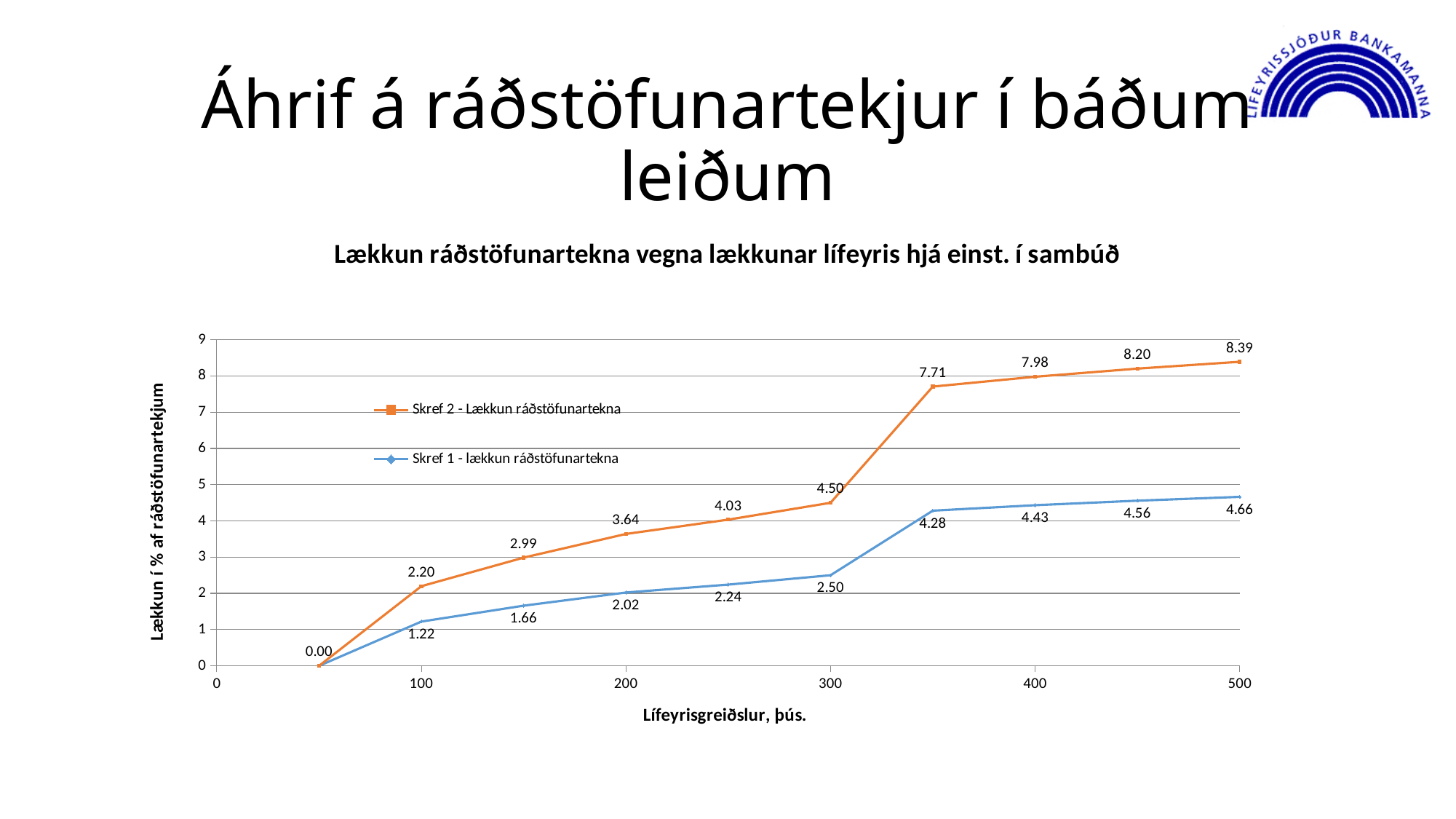
How many data points are plotted for the Skref 2 - Lækkun ráðstöfunartekna series? 10 How many series does the legend list? 2 What is the value of Skref 1 - lækkun ráðstöfunartekna at 300 on the x axis? 2.50 What is the value of Skref 2 - Lækkun ráðstöfunartekna at 100 on the x axis? 2.20 What is the difference between Skref 2 and Skref 1 at 500 on the x axis? 3.73 What is the title of the chart? Lækkun ráðstöfunartekna vegna lækkunar lífeyris hjá einst. í sambúð What kind of chart is shown on the slide? line chart What is the value of Skref 1 - lækkun ráðstöfunartekna at 400 on the x axis? 4.43 Which series has the larger value at 200 on the x axis, Skref 1 or Skref 2? Skref 2 - Lækkun ráðstöfunartekna Do the values of the Skref 2 - Lækkun ráðstöfunartekna series rise or fall as the x axis increases? rise What is the value of Skref 2 - Lækkun ráðstöfunartekna at 500 on the x axis? 8.39 What is the highest value reached by the Skref 1 - lækkun ráðstöfunartekna series? 4.66